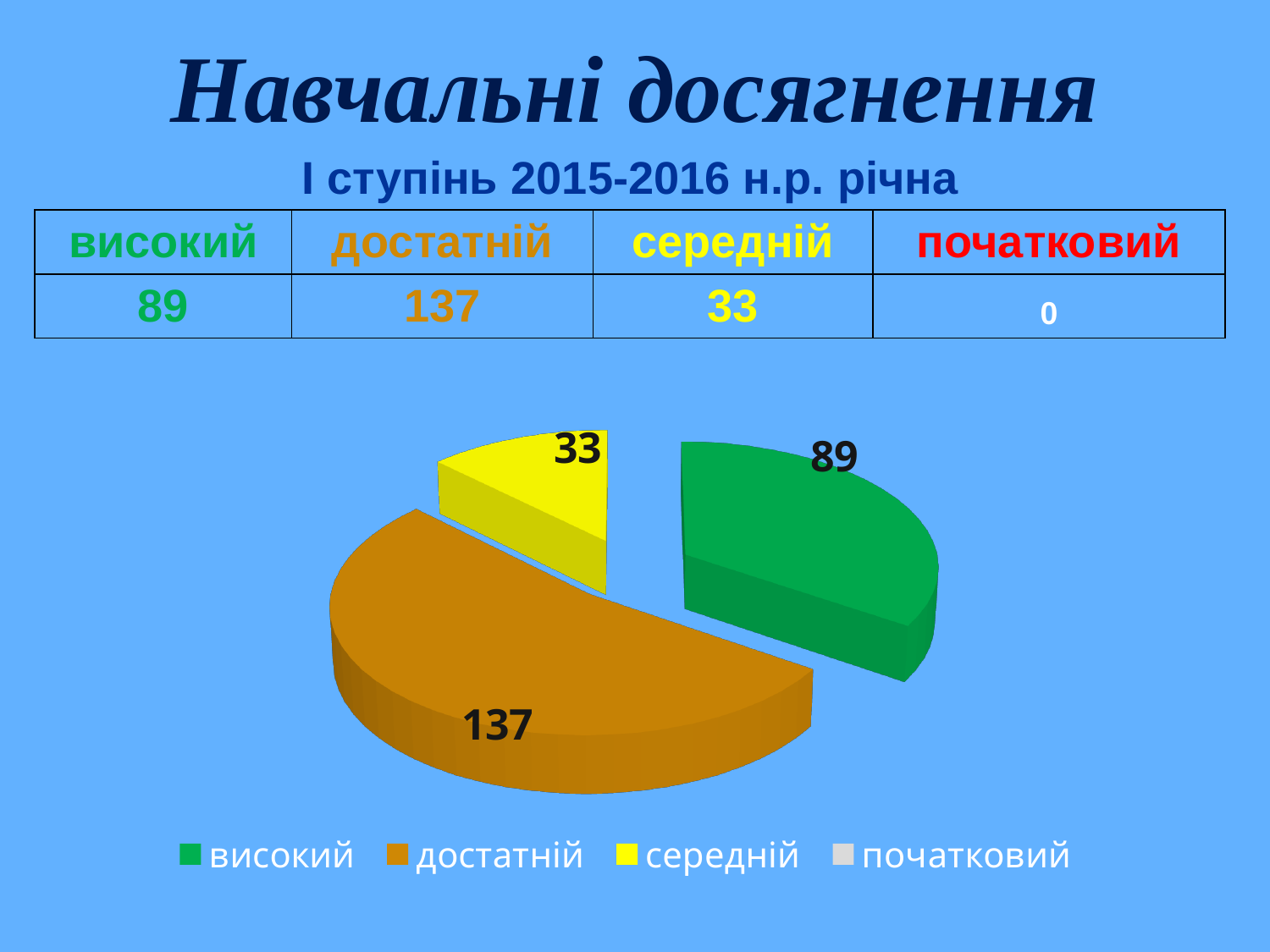
Which category with a visible slice has the smallest value in the pie chart? середній What is the value for the достатній slice of the pie chart? 137 What kind of chart is shown on the slide? pie chart What is the difference between the достатній and високий values in the pie chart? 48 What is the value for the середній slice of the pie chart? 33 How many categories does the legend of the pie chart list? 4 What is the value for the високий slice of the pie chart? 89 What is the difference between the високий and середній values in the pie chart? 56 Which category has the largest slice in the pie chart? достатній What colour is the достатній slice in the pie chart? orange Which is larger in the pie chart, високий or середній? високий What is the total of all values shown in the pie chart? 259